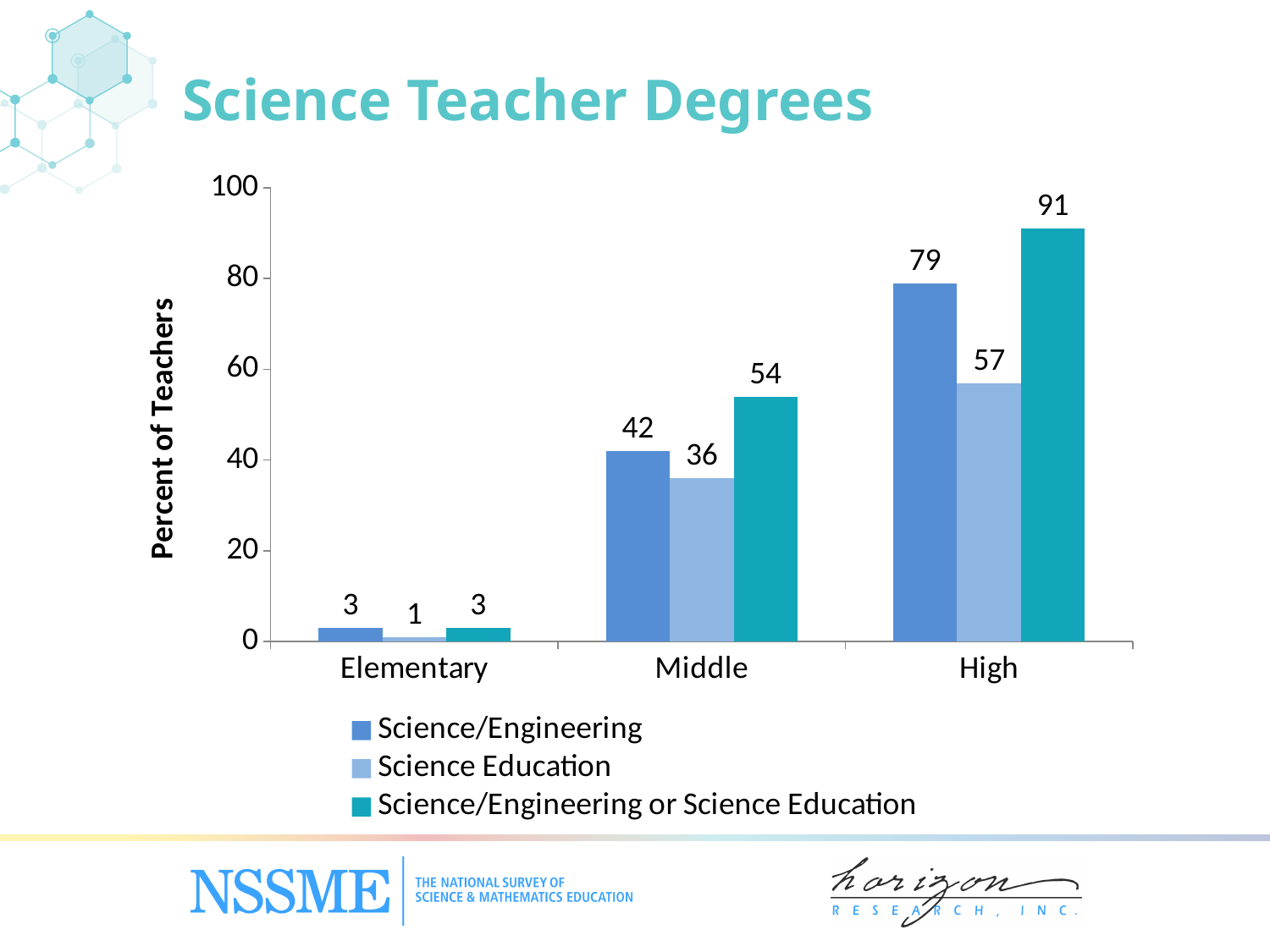
What is the value for Science Education at the Middle level? 36 Do the Science/Engineering values rise or fall from Elementary to High? Rise What kind of chart is shown on the slide? Bar chart How many series does the legend list? 3 What is the value for Science/Engineering or Science Education at the Elementary level? 3 Is the value for Science Education at the High level greater or less than 60? less How many grade-level categories are shown on the x axis? 3 Which grade level has the highest value for Science/Engineering or Science Education? High What percent of High school teachers have a Science/Engineering degree? 79 What is the difference between the Science/Engineering or Science Education values for High and Middle? 37 Which grade level has the lowest value for Science Education? Elementary Which is larger at the Middle level: Science/Engineering or Science Education? Science/Engineering